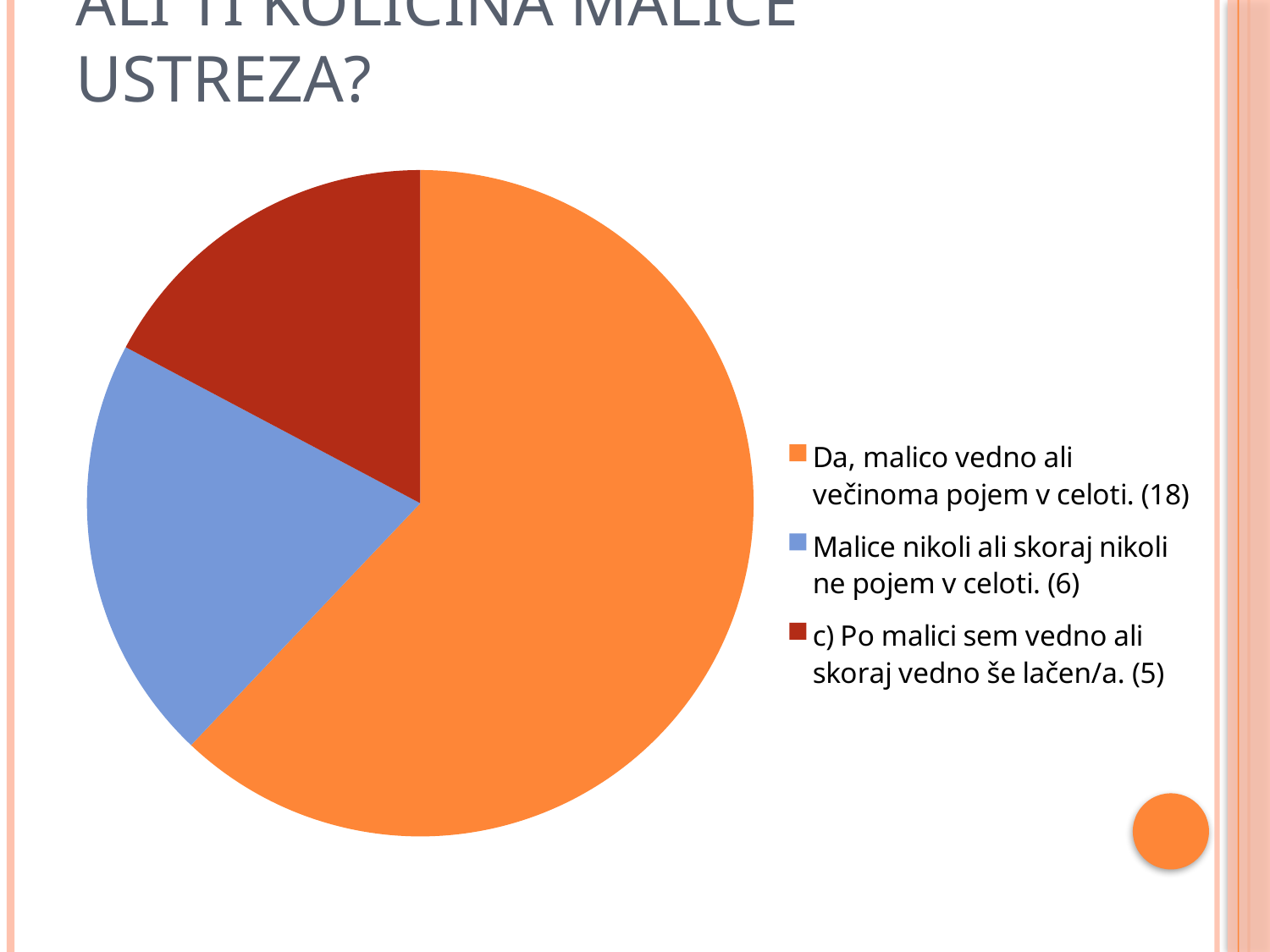
How many entries does the legend list? 3 What colour is the slice for "Malice nikoli ali skoraj nikoli ne pojem v celoti."? blue Which answer has the smallest slice of the pie? c) Po malici sem vedno ali skoraj vedno še lačen/a. Which has more respondents: "Malice nikoli ali skoraj nikoli ne pojem v celoti." or "c) Po malici sem vedno ali skoraj vedno še lačen/a."? Malice nikoli ali skoraj nikoli ne pojem v celoti. Which answer has the largest slice of the pie? Da, malico vedno ali večinoma pojem v celoti. What colour is the slice for "Da, malico vedno ali večinoma pojem v celoti."? orange How many respondents answered "Malice nikoli ali skoraj nikoli ne pojem v celoti."? 6 How many respondents answered "Da, malico vedno ali večinoma pojem v celoti."? 18 What kind of chart is shown on the slide? pie chart How many respondents answered "c) Po malici sem vedno ali skoraj vedno še lačen/a."? 5 What is the difference between the number of respondents who always or mostly eat the whole snack (18) and those who never or almost never eat it all (6)? 12 How many slices does the pie chart have? 3